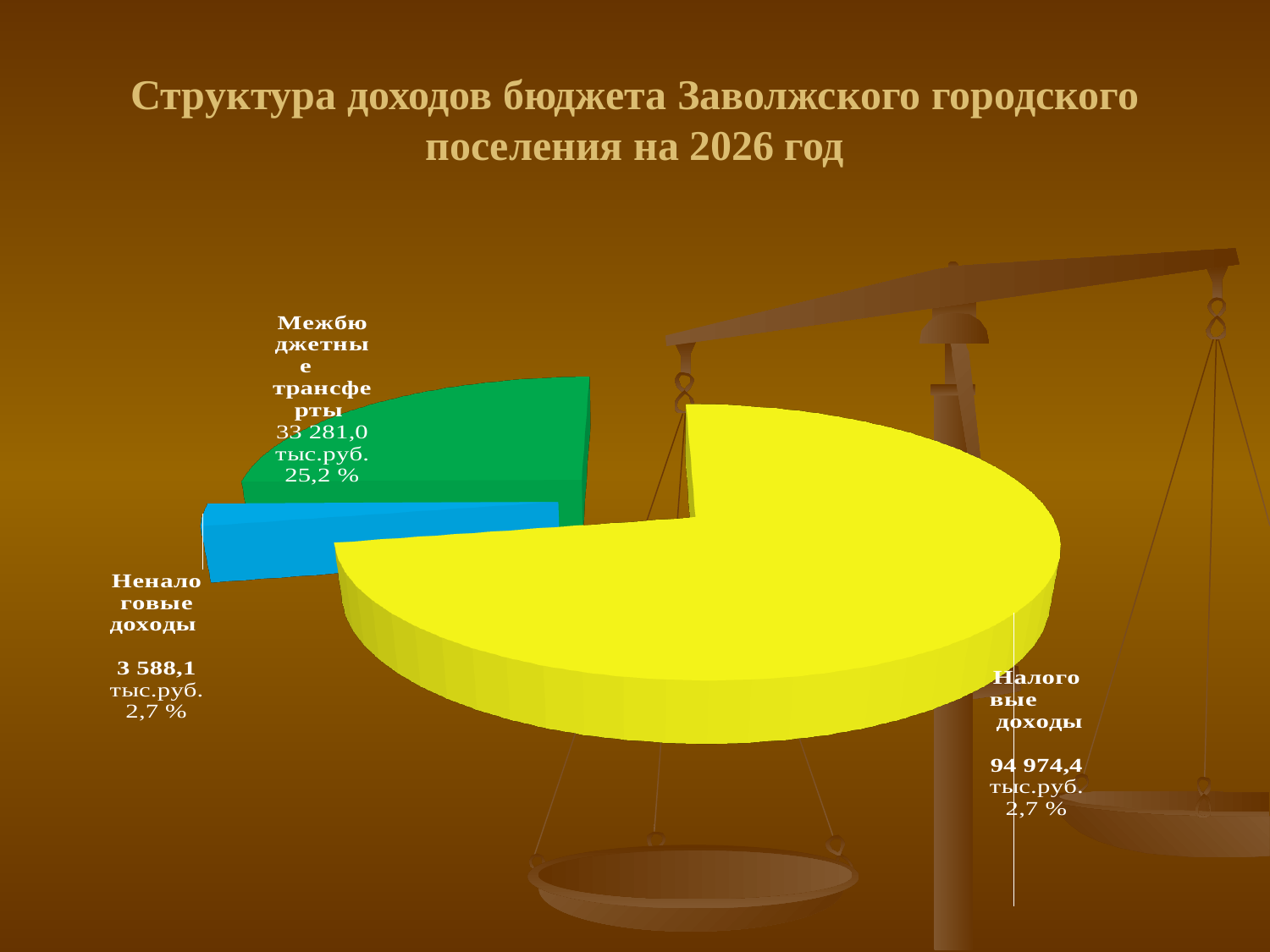
What is the title of the chart? Структура доходов бюджета Заволжского городского поселения на 2026 год Which is larger, Межбюджетные трансферты or Неналоговые доходы? Межбюджетные трансферты What is the value for Налоговые доходы? 94 974,4 тыс.руб. What colour is the slice for Налоговые доходы? Yellow What is the value for Неналоговые доходы? 3 588,1 тыс.руб. What kind of chart is shown on the slide? Pie chart Which category has the largest slice of the pie? Налоговые доходы What is the value for Межбюджетные трансферты? 33 281,0 тыс.руб. What share of the pie does Межбюджетные трансферты represent, as printed on the slide? 25,2 % Which category has the smallest slice of the pie? Неналоговые доходы How many slices does the pie chart have? 3 What is the difference between Межбюджетные трансферты and Неналоговые доходы? 29 692,9 тыс.руб.